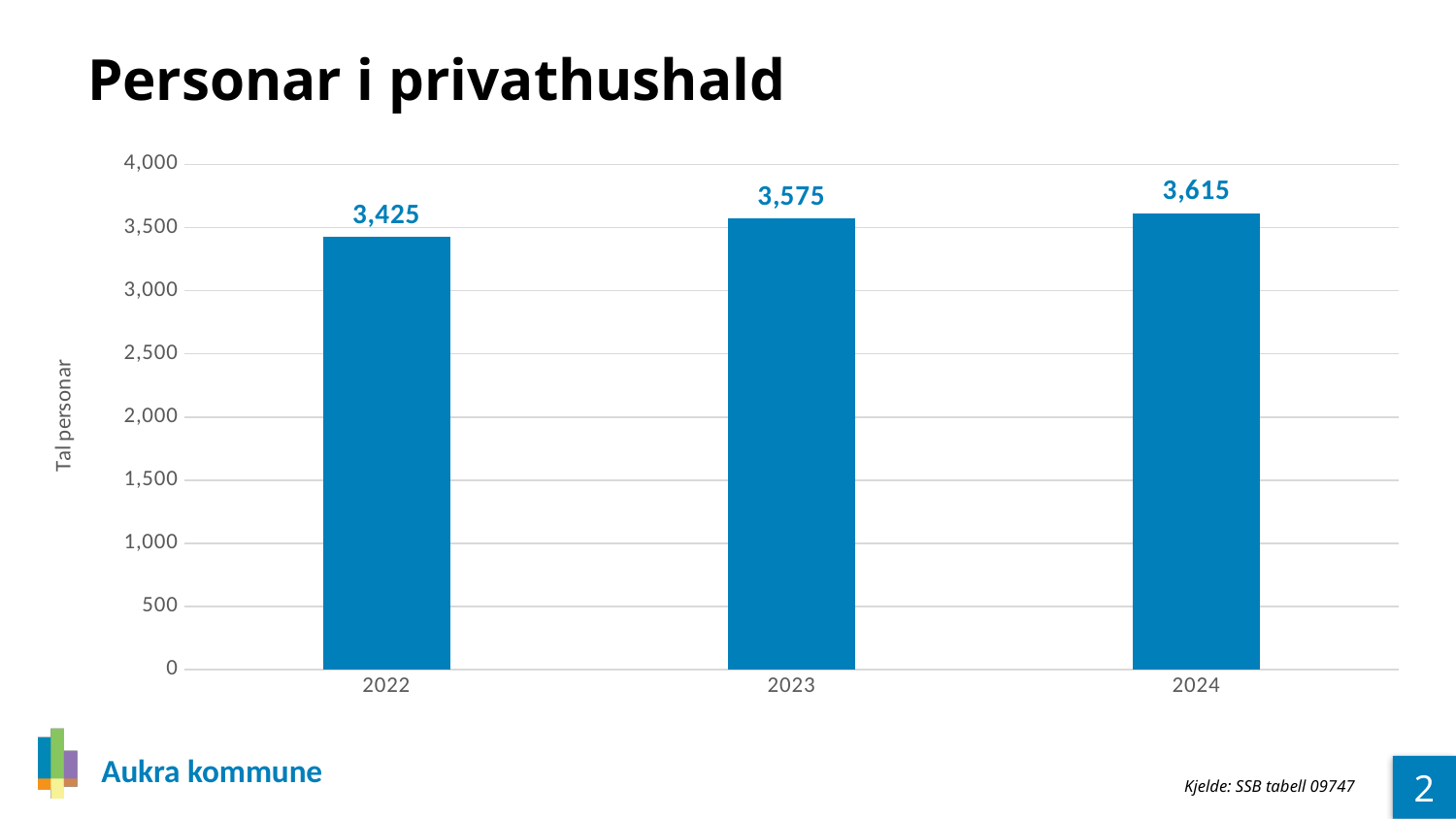
Do the values rise or fall from 2022 to 2024? rise Which year has the highest value? 2024 What kind of chart is shown on the slide? bar chart What is the difference between the values for 2024 and 2022? 190 What is the value for 2024? 3,615 Is the value for 2022 greater or less than 3,500? less Which is larger, the value for 2023 or the value for 2024? 2024 What is the value for 2023? 3,575 How many years are shown on the x axis? 3 What is the difference between the values for 2023 and 2022? 150 What is the value for 2022? 3,425 Which year has the lowest value? 2022